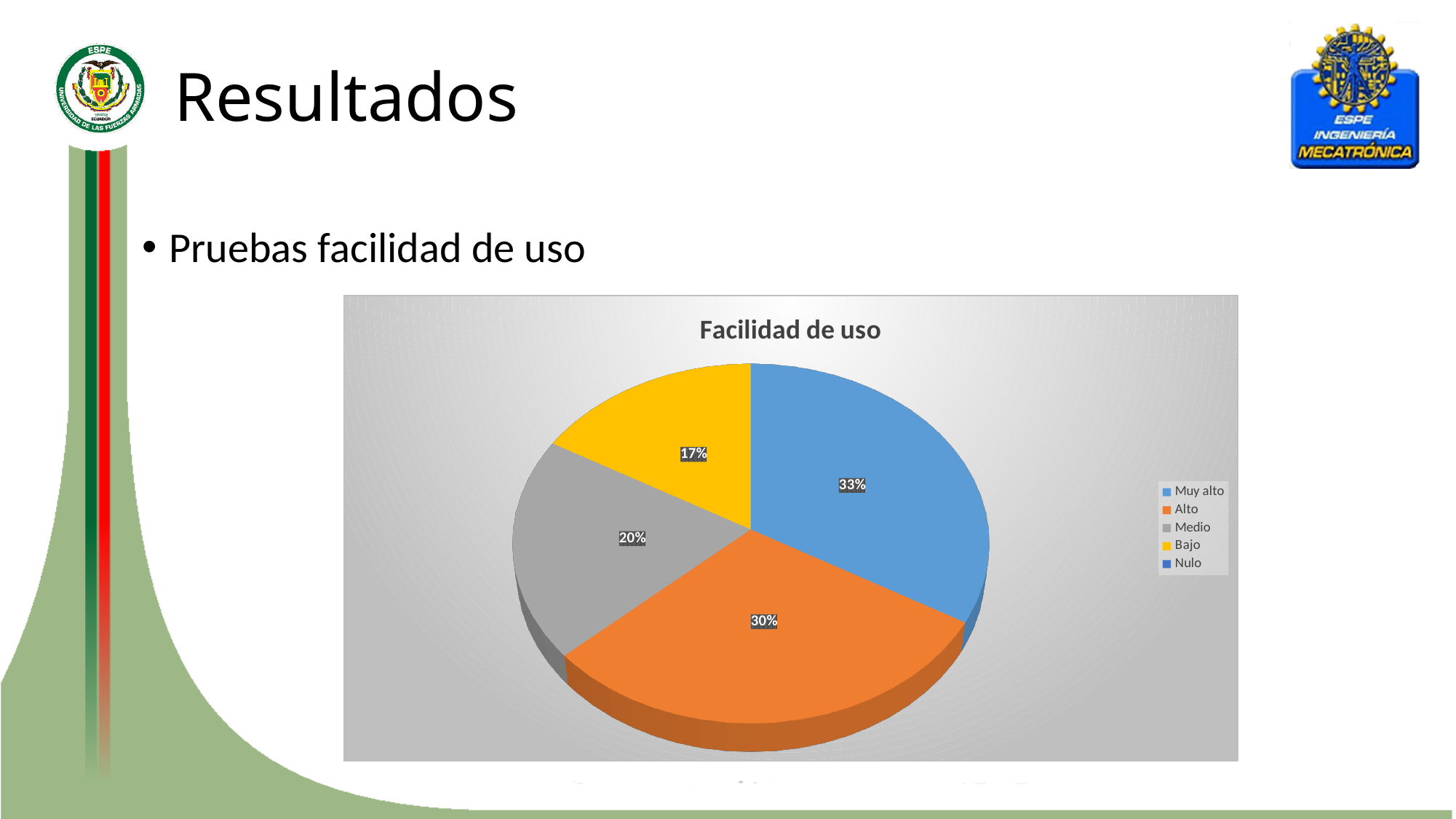
Among the slices with printed labels, which category has the smallest share? Bajo Which slice is larger, Alto or Medio? Alto What percentage is shown for the Bajo slice? 17% What is the title of the chart? Facilidad de uso Which category has the largest share of the pie? Muy alto What percentage of the pie does the Muy alto slice represent? 33% What is the difference in percentage points between the Muy alto and Bajo slices? 16 What percentage is shown for the Alto slice? 30% What kind of chart is shown on the slide? pie chart How many entries does the legend list? 5 What percentage is shown for the Medio slice? 20% What colour is the Medio slice? grey